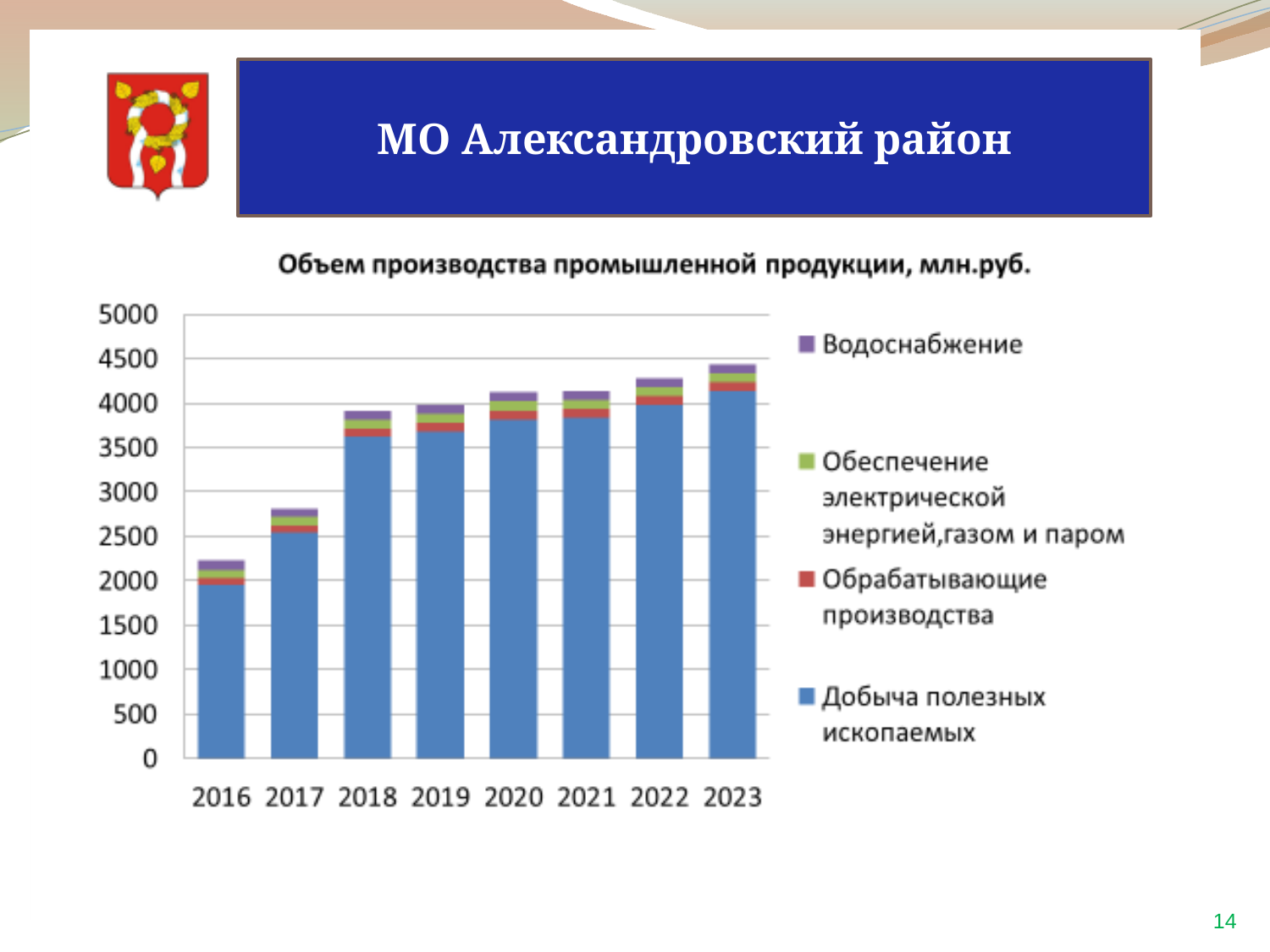
Which year has the highest total bar? 2023 Is the total value for 2017 greater or less than 3000? less How many series does the legend list? 4 Is the total value for 2018 greater or less than 3500? greater Do the total bar heights generally rise or fall from 2016 to 2023? rise Which year has the lowest total bar? 2016 What is the title of the chart? Объем производства промышленной продукции, млн.руб. Which year has the larger total bar, 2017 or 2018? 2018 Is the total value for 2016 greater or less than 2000? greater What kind of chart is shown on the slide? stacked bar chart Which series is shown in blue at the bottom of each bar? Добыча полезных ископаемых How many years are shown on the x axis of the chart? 8